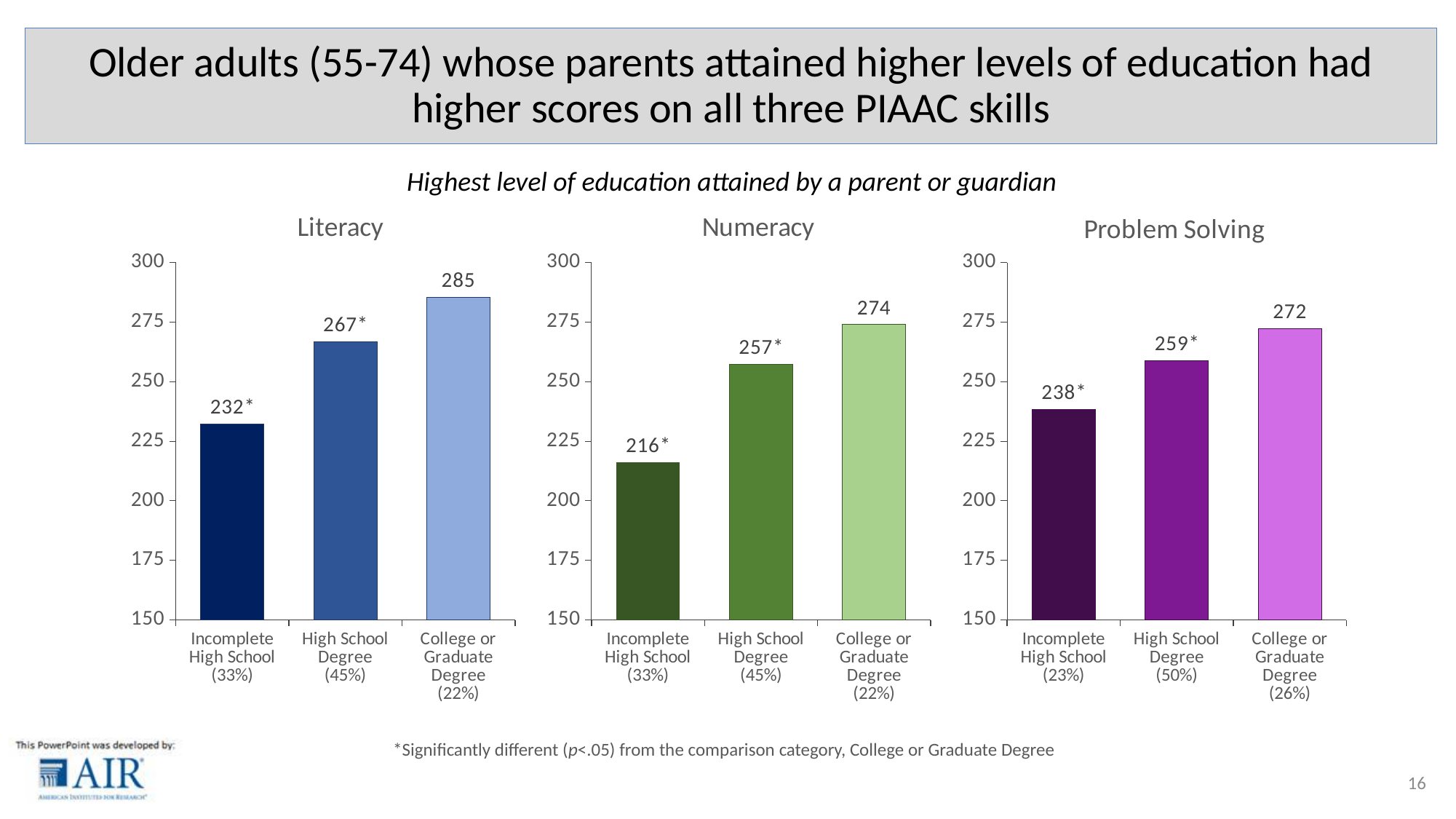
In the Numeracy chart, do the scores rise or fall from Incomplete High School to College or Graduate Degree? rise In the Numeracy chart, is the value for Incomplete High School greater or less than 225? less In the Problem Solving chart, what is the score for High School Degree? 259 How many categories are shown in the Problem Solving chart? 3 Which is larger: the Numeracy score for High School Degree or the Problem Solving score for High School Degree? Problem Solving score for High School Degree In the Literacy chart, what is the score for Incomplete High School? 232 What kind of chart is the Literacy chart? bar chart In the Numeracy chart, what is the score for College or Graduate Degree? 274 In the Literacy chart, which category has the highest score? College or Graduate Degree In the Numeracy chart, which category has the lowest score? Incomplete High School In the Problem Solving chart, what is the difference between the College or Graduate Degree score and the High School Degree score? 13 In the Literacy chart, what is the difference between the College or Graduate Degree score and the Incomplete High School score? 53